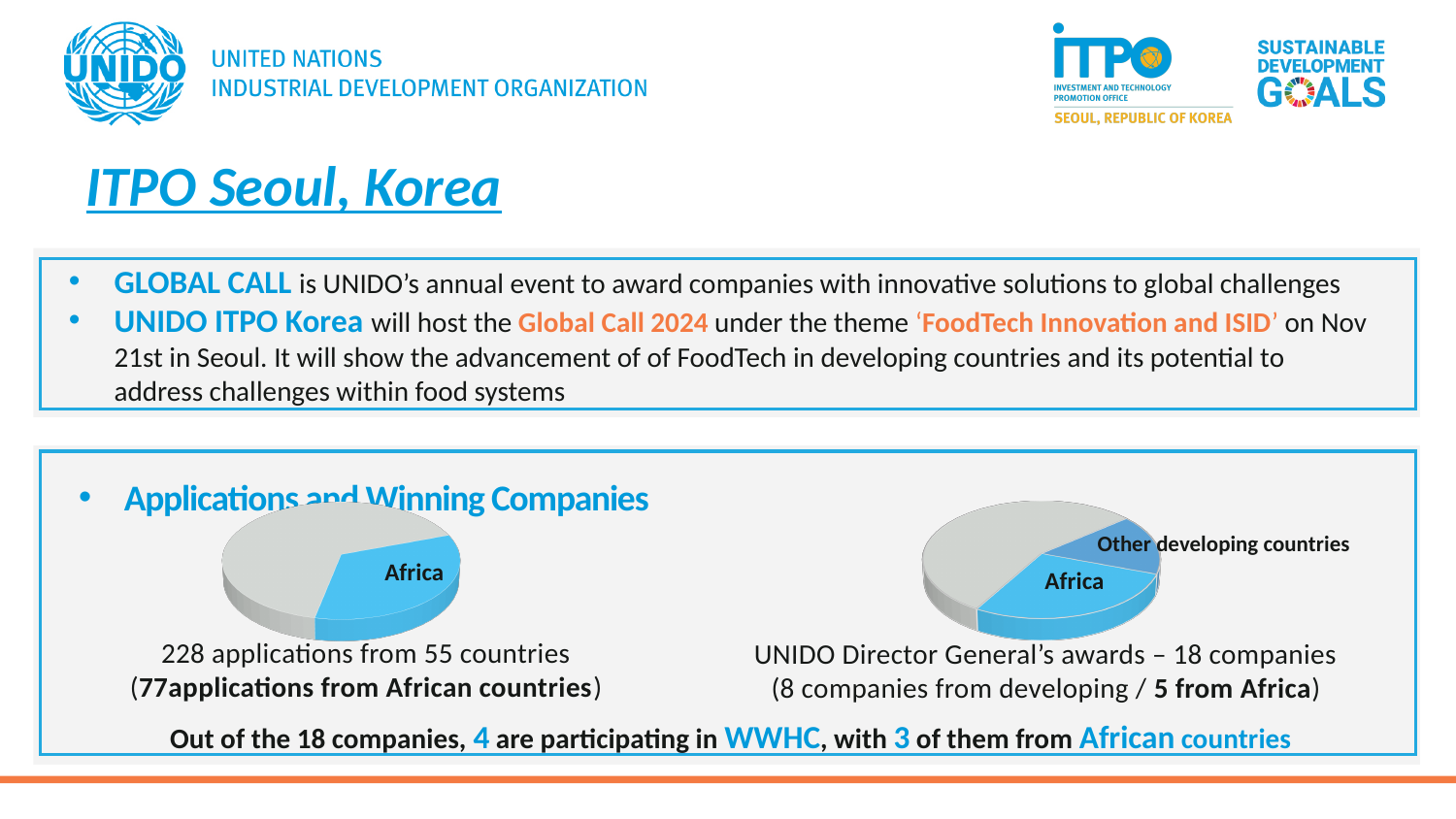
How many labelled slices does the right pie chart have? 2 In the right pie chart, what is the label of the slice next to Africa? Other developing countries In the right pie chart, which slice is larger, Africa or Other developing countries? Africa In the left pie chart, is the Africa slice more or less than half of the pie? less What kind of chart is the left chart under 'Applications and Winning Companies'? pie chart What kind of chart is the right chart under 'Applications and Winning Companies'? pie chart How many labelled slices does the left pie chart have? 1 In the right pie chart, which labelled slice is the smallest? Other developing countries In the left pie chart, what is the label on the blue slice? Africa In the right pie chart, is the Africa slice more or less than half of the pie? less